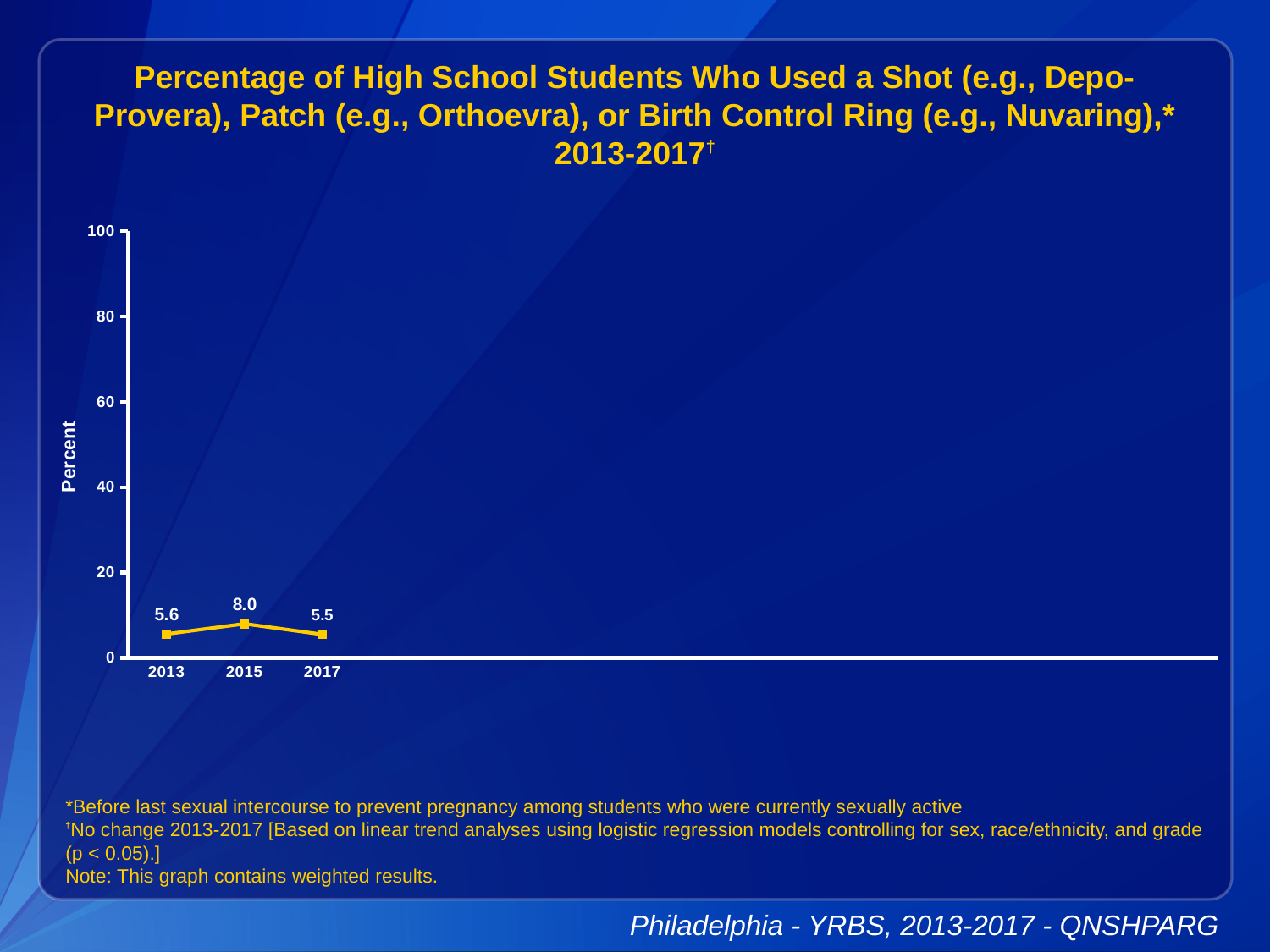
What is the difference between the values for 2015 and 2017? 2.5 What kind of chart is shown on the slide? line chart What is the label of the y axis? Percent What is the value for 2013? 5.6 Which year has the lowest value? 2017 Is the value for 2015 greater or less than 20? less Which year has the highest value? 2015 What is the difference between the values for 2015 and 2013? 2.4 How many years are plotted on the chart? 3 What is the value for 2017? 5.5 What is the value for 2015? 8.0 Which is larger, the value for 2013 or the value for 2015? 2015